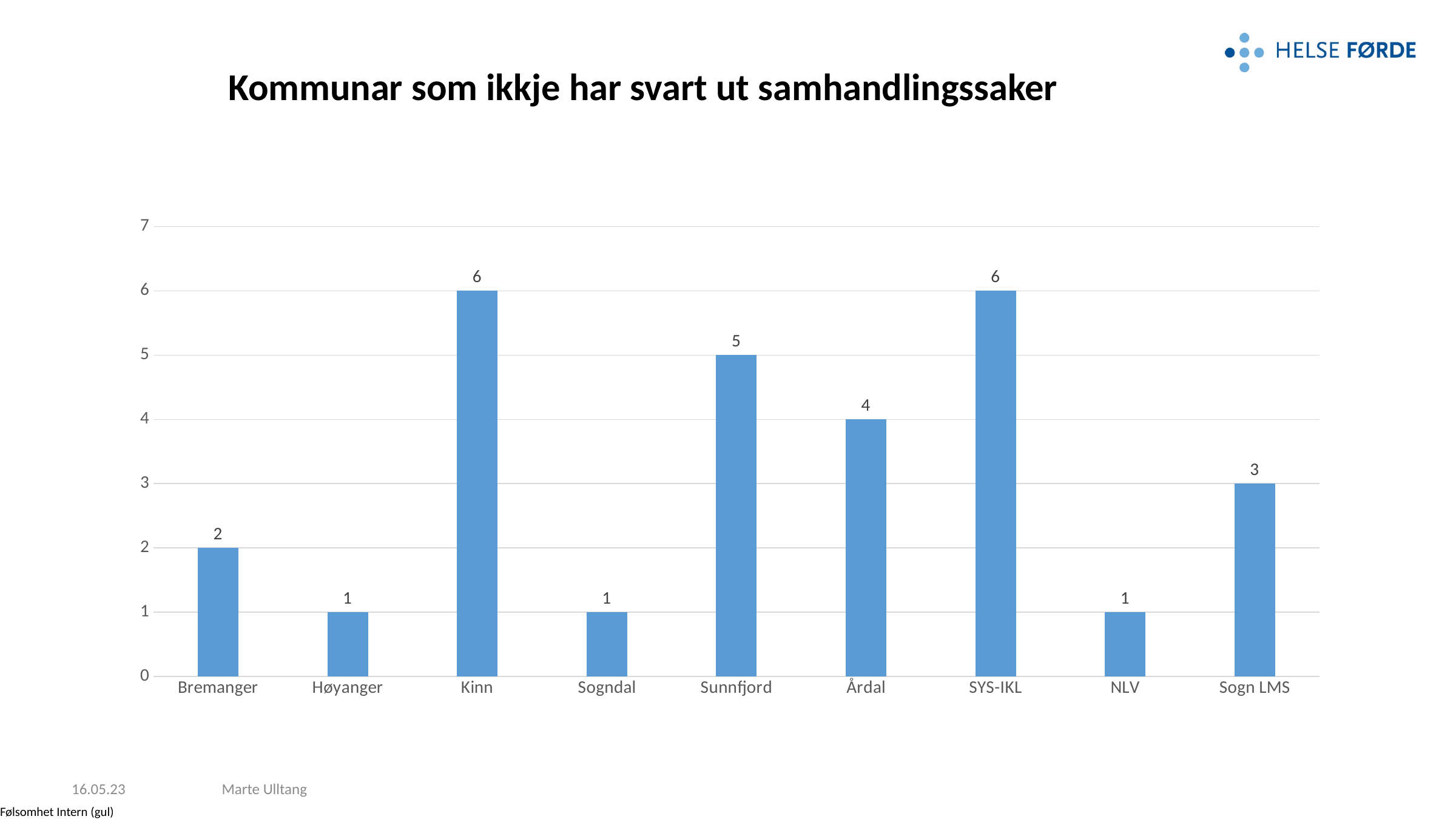
What kind of chart is shown on the slide? Bar chart What is the value for Sogn LMS? 3 How many categories are shown on the x axis? 9 What is the value for NLV? 1 Which is larger, the value for Årdal or the value for Bremanger? Årdal What is the value for Årdal? 4 What is the difference between the values for Sunnfjord and Sogn LMS? 2 What is the value for Kinn? 6 What is the title of the chart? Kommunar som ikkje har svart ut samhandlingssaker What is the value for Sunnfjord? 5 What is the value for Bremanger? 2 What is the difference between the values for Kinn and Sogndal? 5